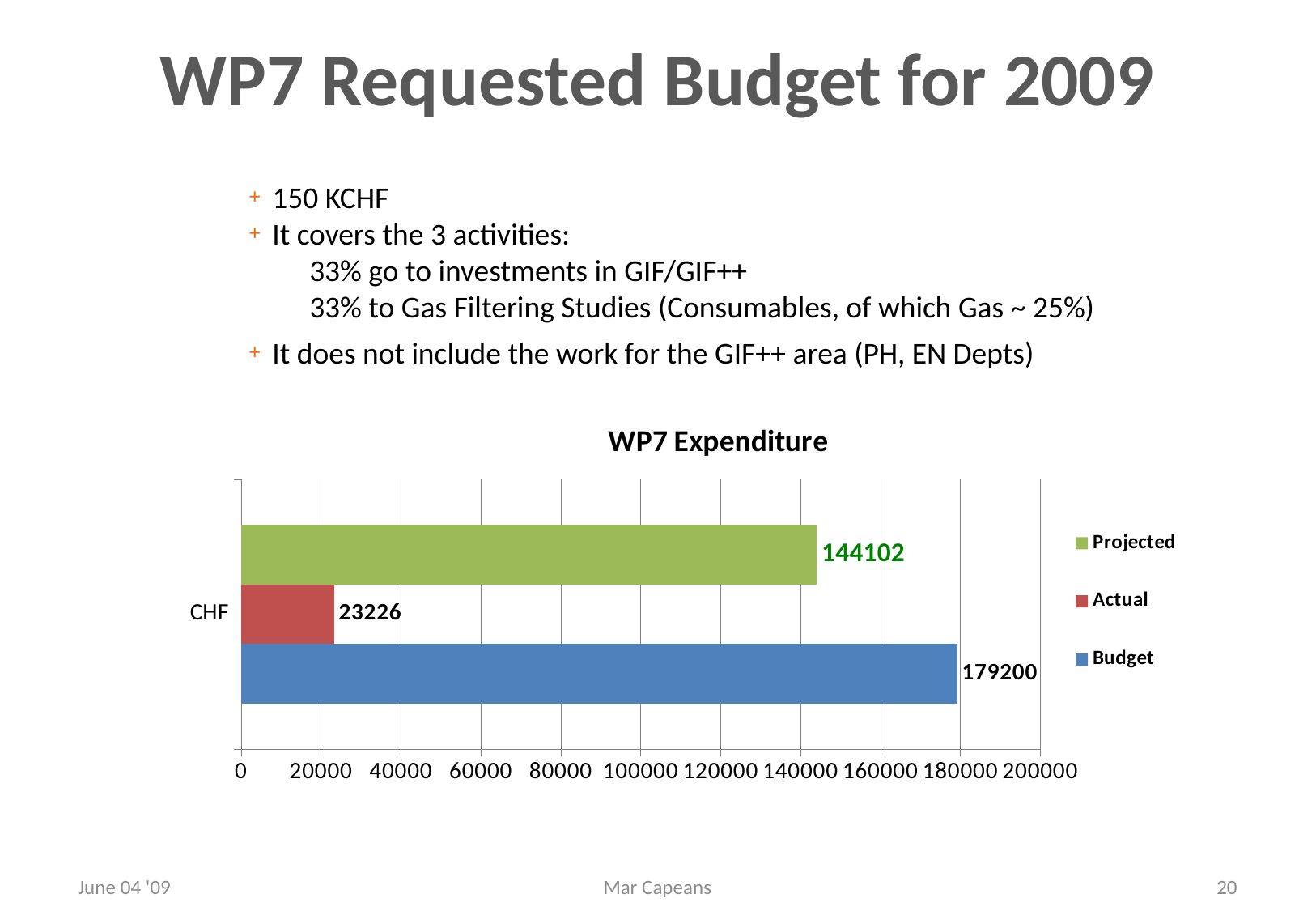
What is the Projected value in the WP7 Expenditure chart? 144102 What is the Budget value in the WP7 Expenditure chart? 179200 Which is larger in the WP7 Expenditure chart, Projected or Actual? Projected Which series has the highest value in the WP7 Expenditure chart? Budget Which series has the lowest value in the WP7 Expenditure chart? Actual What is the Actual value in the WP7 Expenditure chart? 23226 What is the category label on the vertical axis of the WP7 Expenditure chart? CHF What is the difference between the Budget and Projected values in the WP7 Expenditure chart? 35098 Is the Projected value in the WP7 Expenditure chart greater or less than 140000? greater What kind of chart is the WP7 Expenditure chart? bar chart How many series does the legend of the WP7 Expenditure chart list? 3 What is the difference between the Projected and Actual values in the WP7 Expenditure chart? 120876